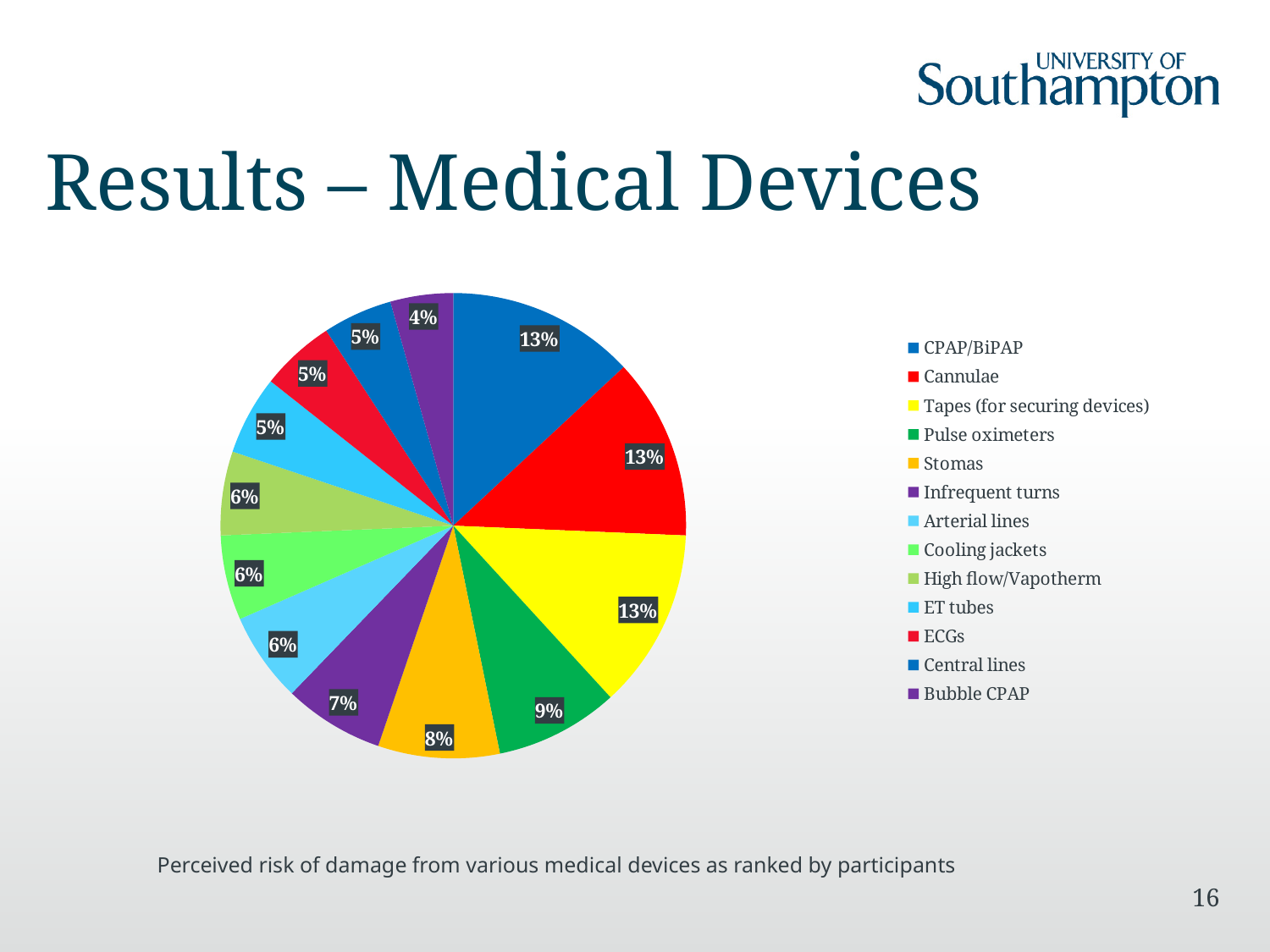
What is the difference in percentage points between CPAP/BiPAP and Bubble CPAP? 9 percentage points What percentage is shown for Stomas? 8% What share of the pie does CPAP/BiPAP have? 13% Which category has the smallest slice of the pie? Bubble CPAP How many entries does the legend list? 13 What percentage is shown for Pulse oximeters? 9% What percentage is shown for Bubble CPAP? 4% What does the caption below the chart say the pie chart shows? Perceived risk of damage from various medical devices as ranked by participants How many slices does the pie chart have? 13 What percentage is shown for Infrequent turns? 7% Which is larger, the slice for Pulse oximeters or the slice for Stomas? Pulse oximeters What kind of chart is shown on the slide? pie chart